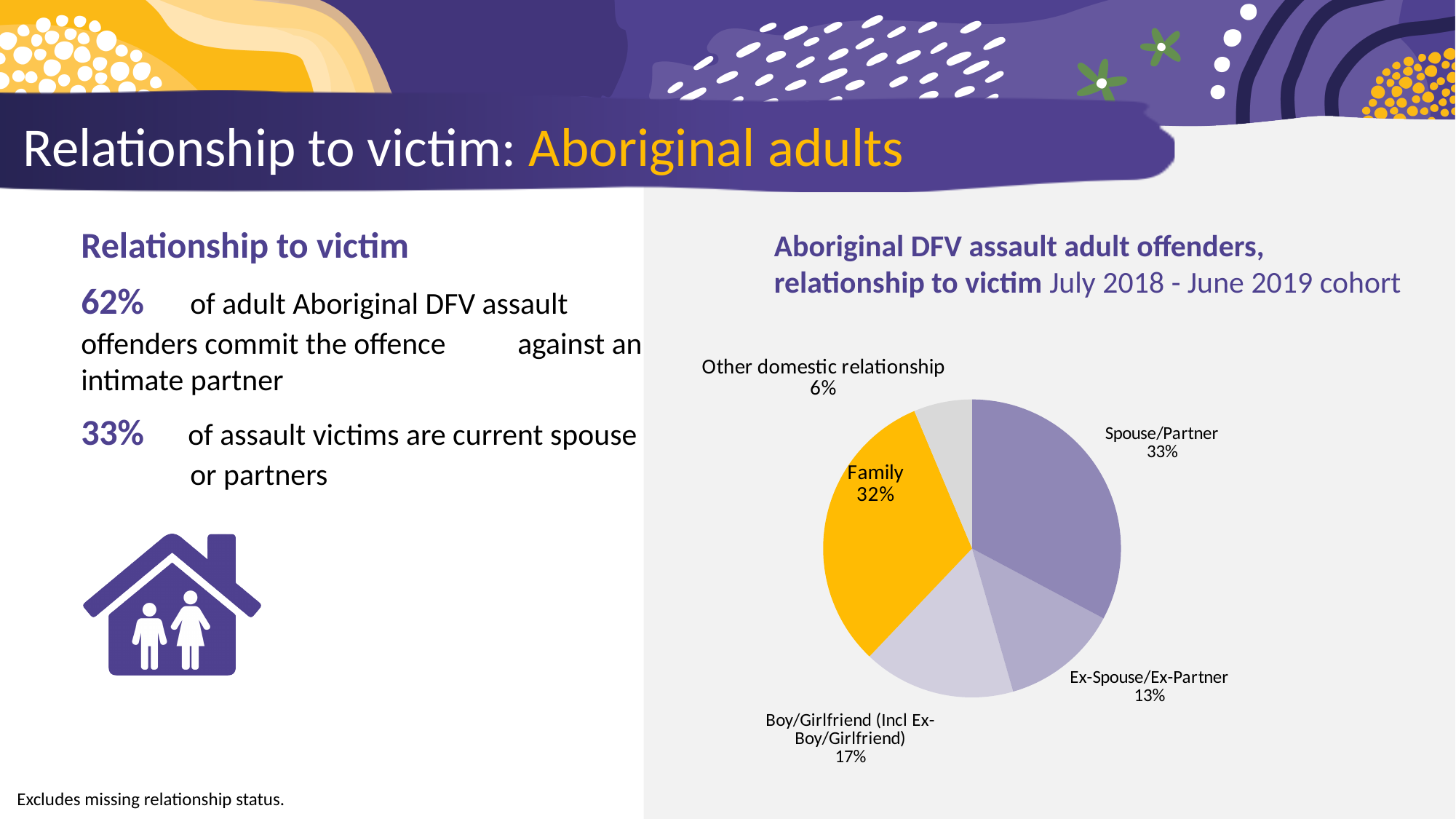
What share of the pie is Spouse/Partner? 33% What is the value for Other domestic relationship? 6% What is the difference between the Boy/Girlfriend (Incl Ex-Boy/Girlfriend) share and the Ex-Spouse/Ex-Partner share? 4% What is the title of the pie chart? Aboriginal DFV assault adult offenders, relationship to victim July 2018 - June 2019 cohort How many categories are shown in the pie chart? 5 What kind of chart is shown on the slide? Pie chart What share of the pie is Family? 32% What is the value for Ex-Spouse/Ex-Partner? 13% What is the value for Boy/Girlfriend (Incl Ex-Boy/Girlfriend)? 17% Which category has the smallest slice of the pie? Other domestic relationship Which slice of the pie is coloured yellow? Family Which is larger, the Ex-Spouse/Ex-Partner slice or the Boy/Girlfriend (Incl Ex-Boy/Girlfriend) slice? Boy/Girlfriend (Incl Ex-Boy/Girlfriend)